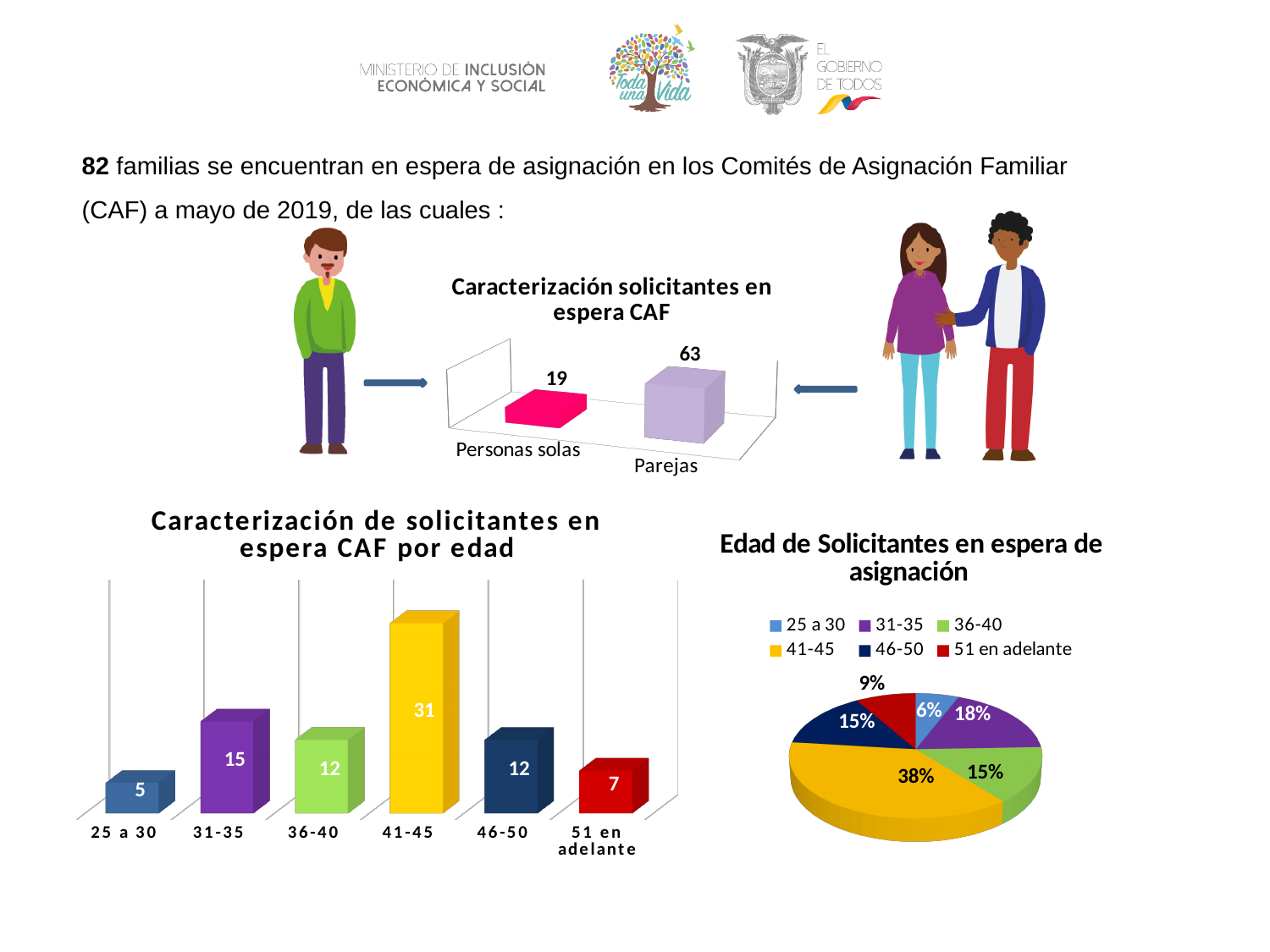
In the chart 'Caracterización de solicitantes en espera CAF por edad', what is the difference between 31-35 and 51 en adelante? 8 What kind of chart is 'Edad de Solicitantes en espera de asignación'? Pie chart In the chart 'Caracterización solicitantes en espera CAF', what is the value for Personas solas? 19 In the chart 'Caracterización solicitantes en espera CAF', what is the value for Parejas? 63 In the chart 'Caracterización de solicitantes en espera CAF por edad', which is larger, 31-35 or 46-50? 31-35 How many entries does the legend of the pie chart 'Edad de Solicitantes en espera de asignación' list? 6 In the chart 'Caracterización de solicitantes en espera CAF por edad', what is the value for 41-45? 31 In the chart 'Caracterización de solicitantes en espera CAF por edad', how many age categories are shown? 6 In the chart 'Caracterización de solicitantes en espera CAF por edad', which age group has the lowest value? 25 a 30 In the chart 'Caracterización solicitantes en espera CAF', what is the difference between Parejas and Personas solas? 44 In the chart 'Caracterización de solicitantes en espera CAF por edad', which age group has the highest value? 41-45 In the pie chart 'Edad de Solicitantes en espera de asignación', what share does 41-45 have? 38%